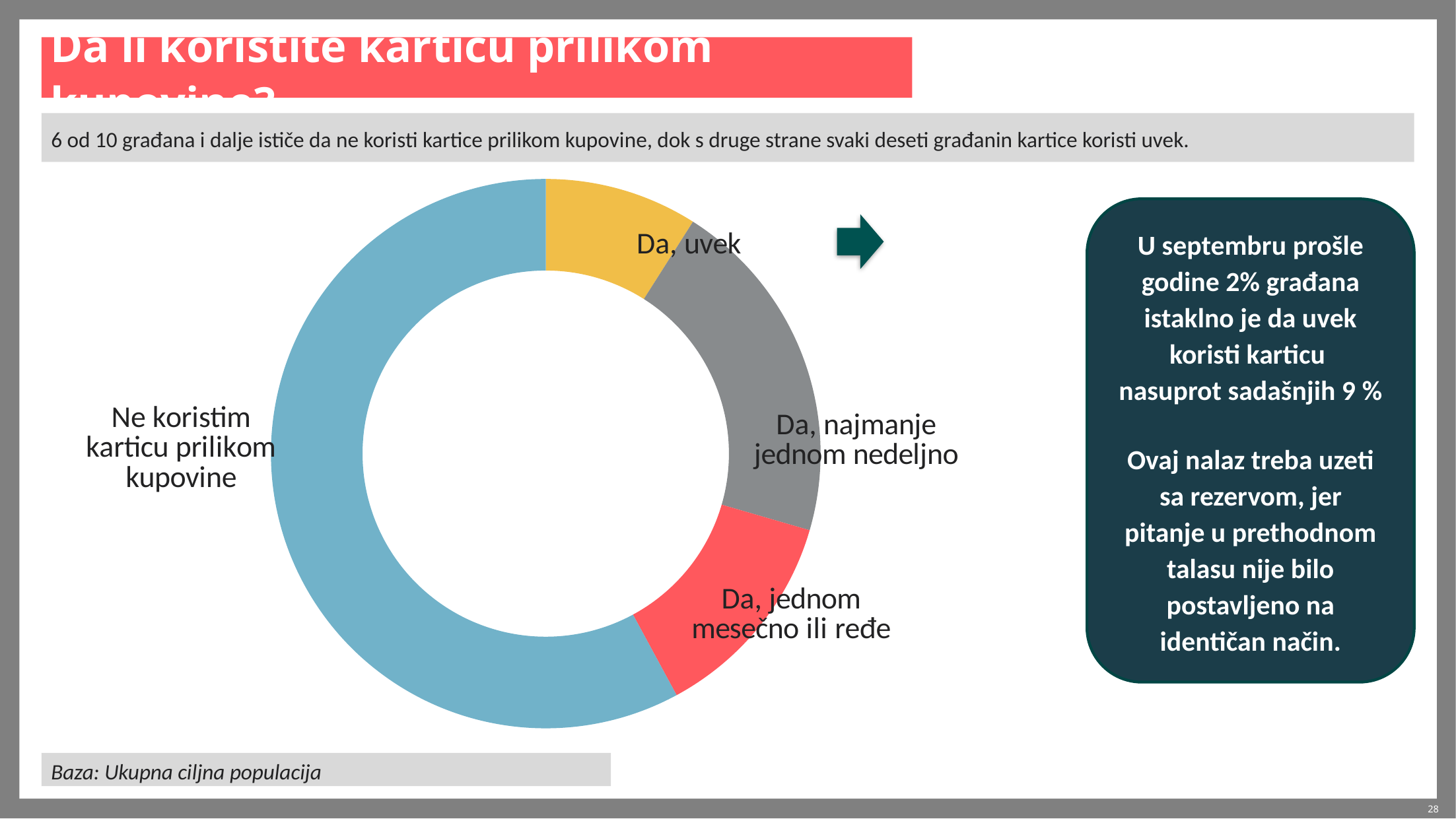
What colour is the "Da, uvek" slice in the donut chart? Yellow What colour is the "Ne koristim karticu prilikom kupovine" slice in the donut chart? Light blue Which slice is larger: "Da, najmanje jednom nedeljno" or "Da, jednom mesečno ili ređe"? Da, najmanje jednom nedeljno Does the "Ne koristim karticu prilikom kupovine" slice take up more or less than half of the donut chart? More Which slice is larger: "Ne koristim karticu prilikom kupovine" or "Da, najmanje jednom nedeljno"? Ne koristim karticu prilikom kupovine How many categories (slices) does the donut chart have? 4 Which slice is larger: "Da, najmanje jednom nedeljno" or "Da, uvek"? Da, najmanje jednom nedeljno Which category has the largest slice in the donut chart? Ne koristim karticu prilikom kupovine What kind of chart is shown on the slide? Donut (pie) chart